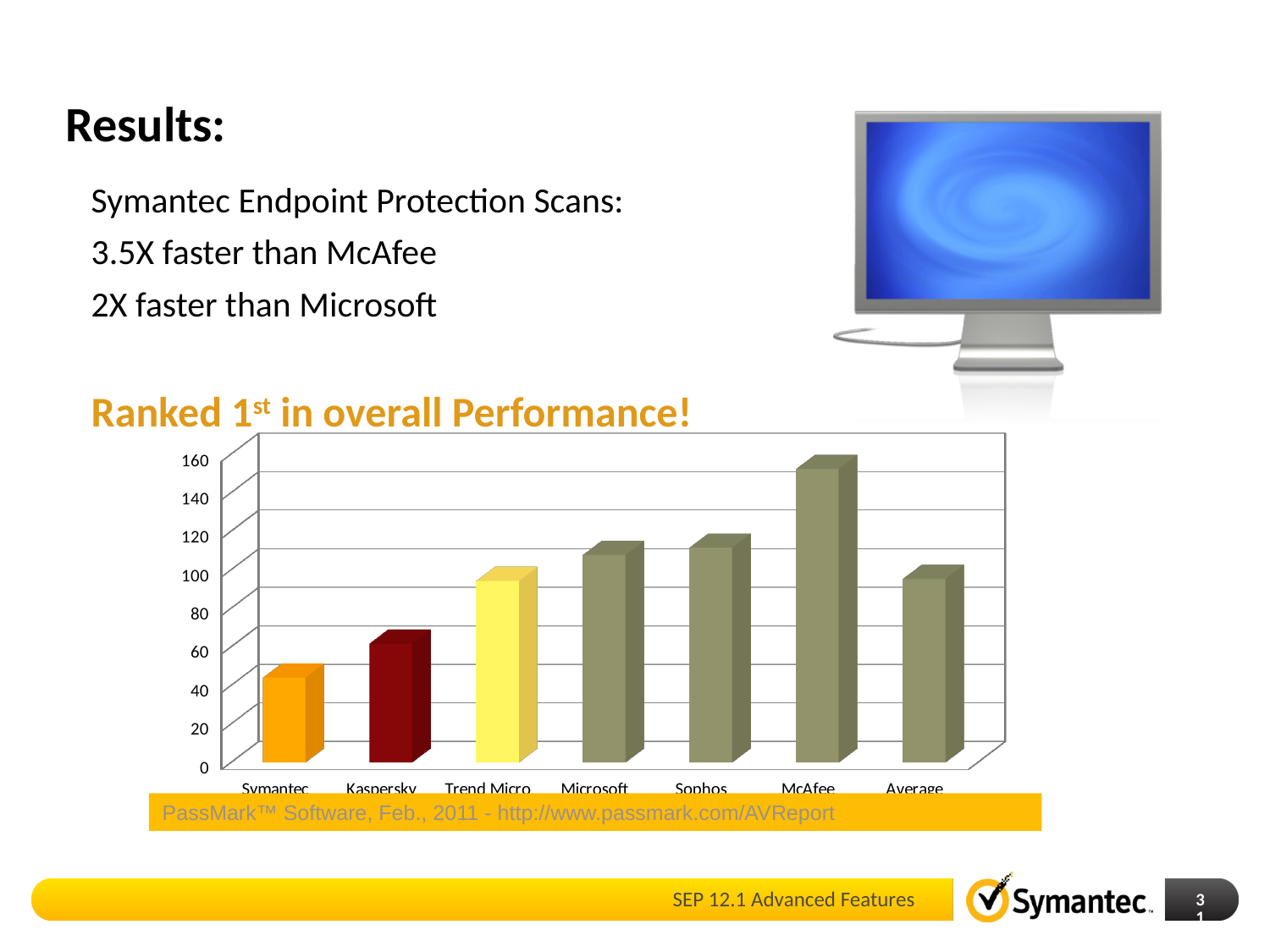
What kind of chart is shown on the slide? bar chart What is the highest value shown on the chart's vertical axis? 160 Which has the larger value, Microsoft or Kaspersky? Microsoft Is the value for McAfee greater or less than 140? greater Do the bar values rise or fall along the x axis from Symantec to McAfee? rise Which category has the highest bar in the chart? McAfee Is the value for Symantec greater or less than 60? less Is the value for Sophos greater or less than 100? greater Which has the larger value, McAfee or Symantec? McAfee Which category has the lowest bar in the chart? Symantec How many categories are shown on the x axis of the chart? 7